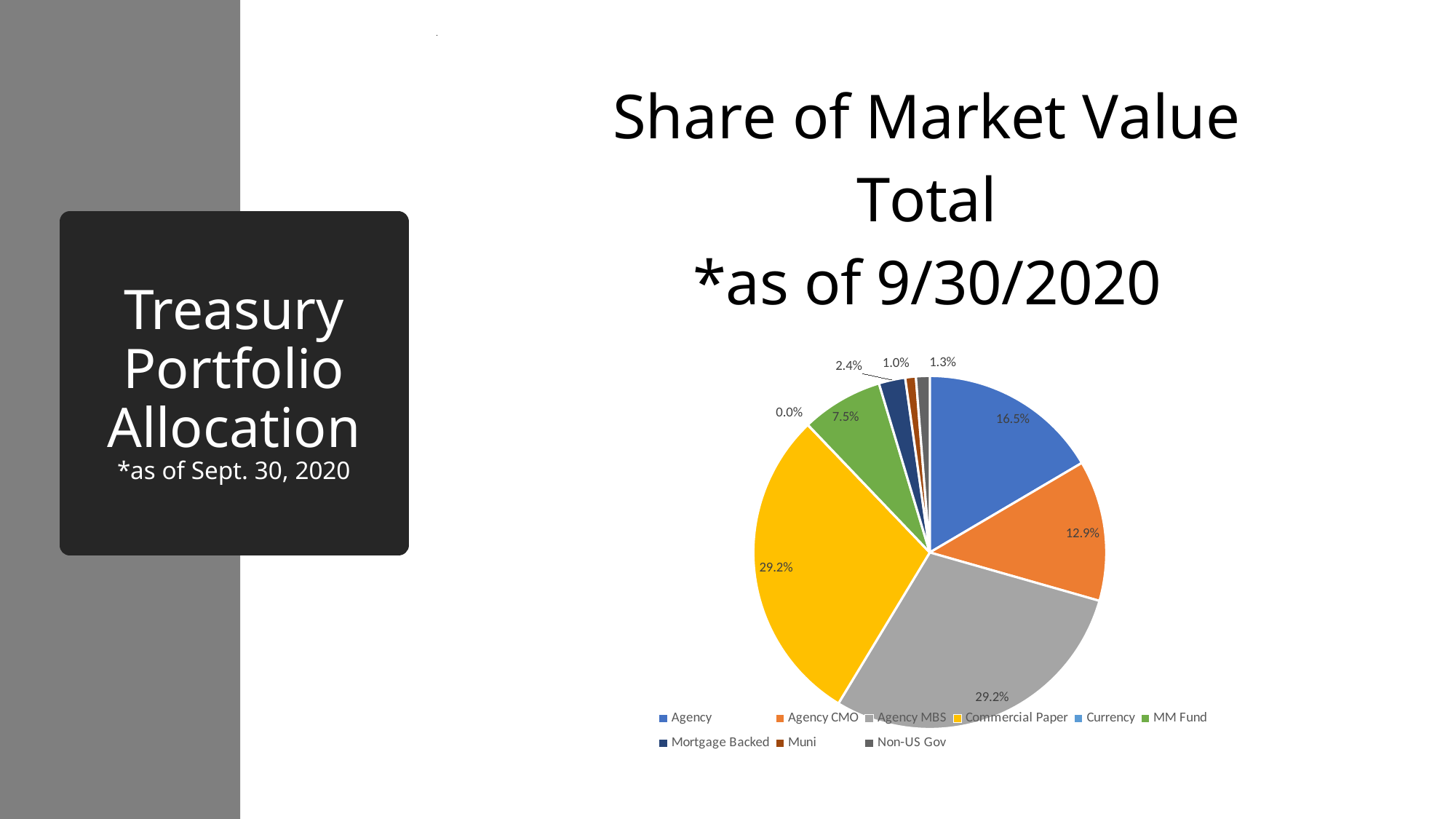
What share of market value does MM Fund represent? 7.5% What is the title of the chart? Share of Market Value Total *as of 9/30/2020 Which is larger, the share for Agency or the share for Agency CMO? Agency Which category has the smallest share of market value? Currency What share of market value does Agency CMO represent? 12.9% How many categories does the legend list? 9 What colour is the Commercial Paper slice? yellow What share of market value does Mortgage Backed represent? 2.4% What share of market value does Agency represent? 16.5% What share of market value does Commercial Paper represent? 29.2% What type of chart is shown on the slide? pie chart What is the difference between the share for Agency and the share for Agency CMO? 3.6%